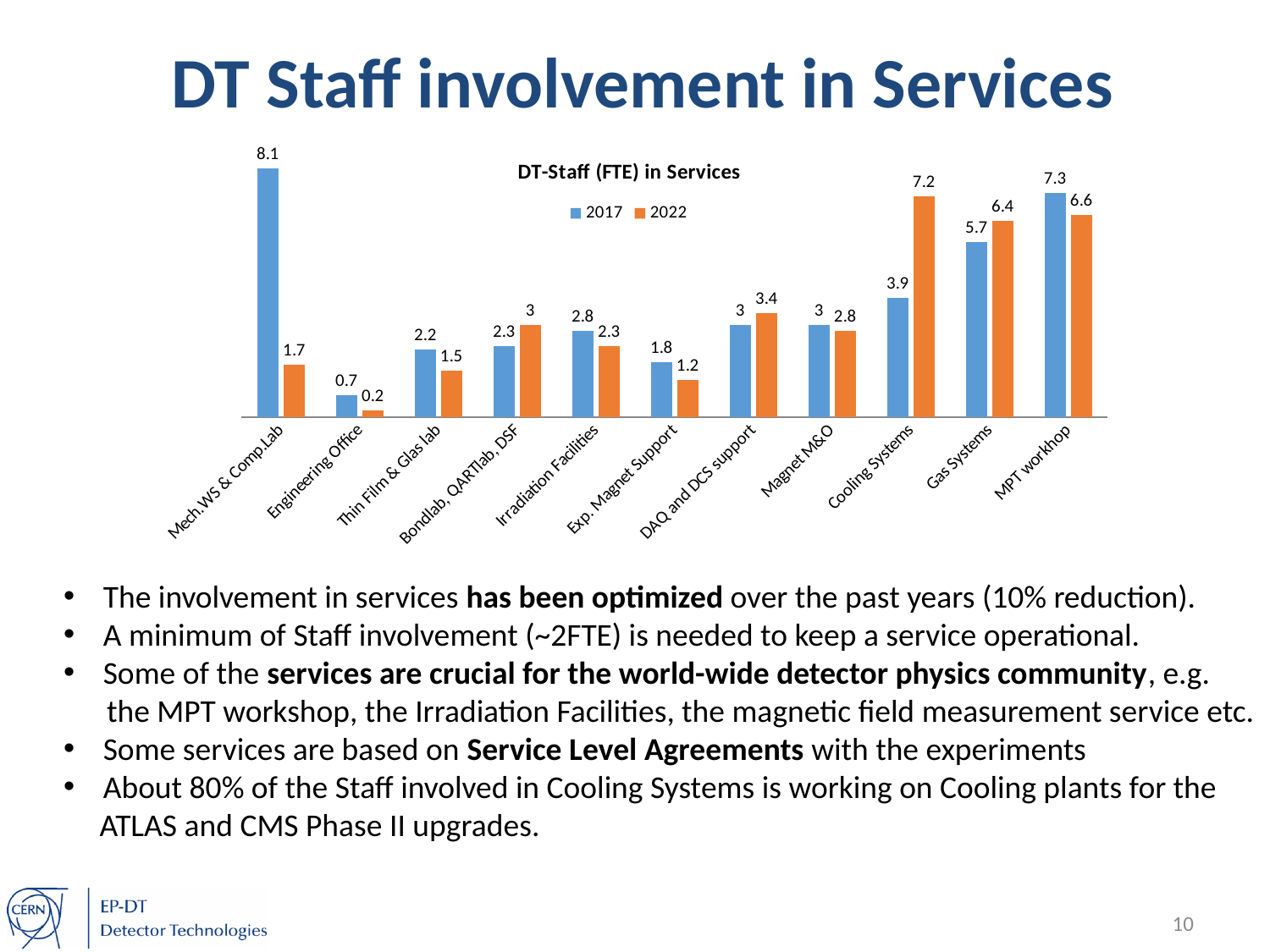
Which category has the highest 2017 value? Mech.WS & Comp.Lab What is the difference between the 2022 and 2017 values for Cooling Systems? 3.3 What is the 2022 value for Mech.WS & Comp.Lab? 1.7 What is the 2022 value for Gas Systems? 6.4 How many categories are shown on the x axis? 11 What is the 2017 value for Cooling Systems? 3.9 Which category has the highest 2022 value? Cooling Systems What is the difference between the 2017 and 2022 values for Mech.WS & Comp.Lab? 6.4 How many series does the legend list? 2 What kind of chart is shown on the slide? Bar chart Which category has the lowest 2022 value? Engineering Office For MPT workshop, which is larger, the 2017 value or the 2022 value? 2017